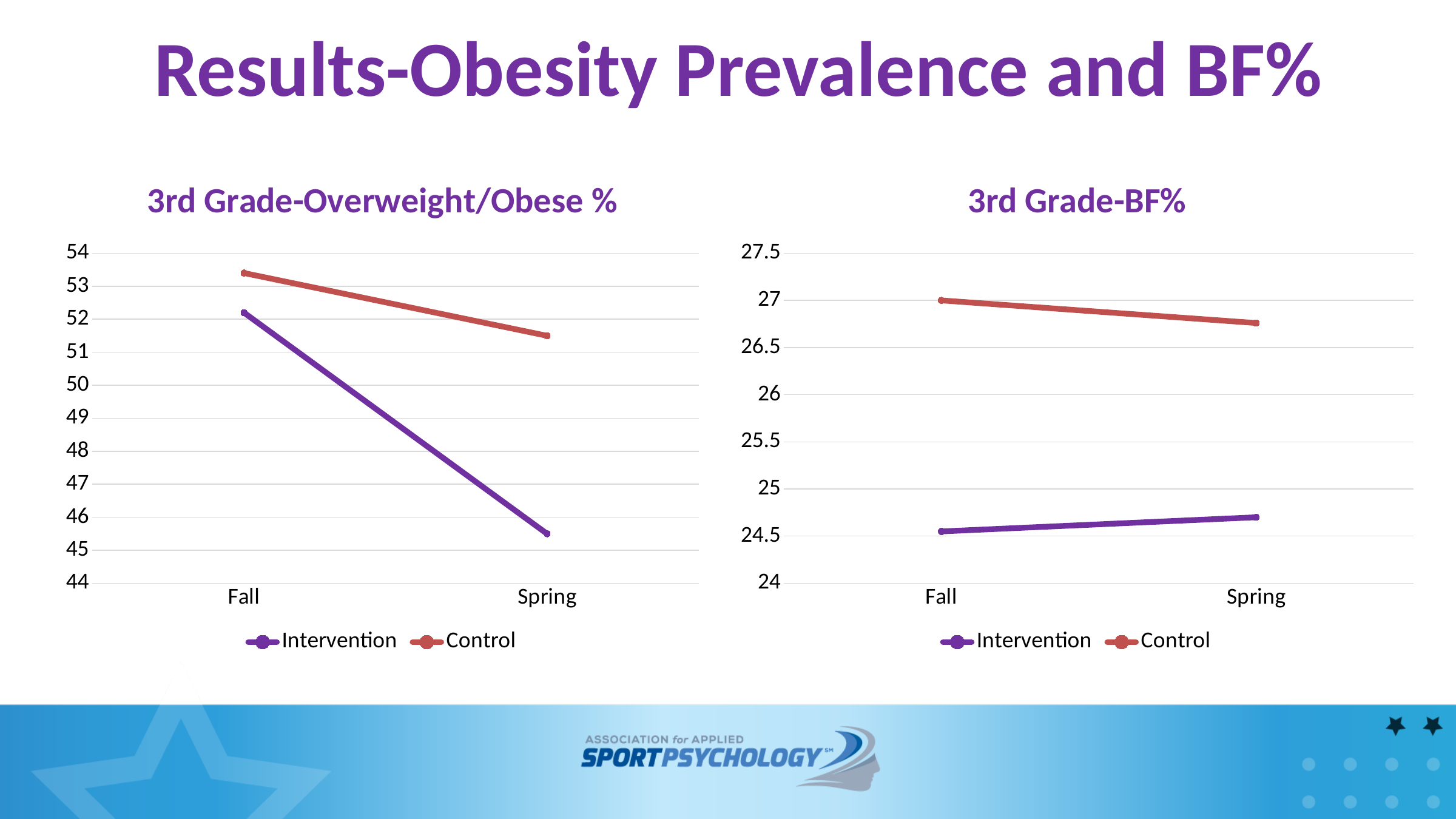
How many series does the legend of the "3rd Grade-BF%" chart list? 2 In the "3rd Grade-BF%" chart, is the Control value at Spring greater or less than 26.5? greater How many time points are shown on the x axis of the "3rd Grade-Overweight/Obese %" chart? 2 In the "3rd Grade-BF%" chart, does the Intervention line rise or fall from Fall to Spring? rise In the "3rd Grade-BF%" chart, what colour is the Control line? red In the "3rd Grade-Overweight/Obese %" chart, which series has the higher value at Spring, Intervention or Control? Control In the "3rd Grade-Overweight/Obese %" chart, is the Control value at Fall greater or less than 53? greater What kind of chart is the "3rd Grade-Overweight/Obese %" chart? line chart In the "3rd Grade-Overweight/Obese %" chart, is the Intervention value at Spring greater or less than 46? less In the "3rd Grade-BF%" chart, what is the Control value at Fall? 27 In the "3rd Grade-BF%" chart, which series has the higher value at Spring, Intervention or Control? Control In the "3rd Grade-Overweight/Obese %" chart, does the Intervention line rise or fall from Fall to Spring? fall